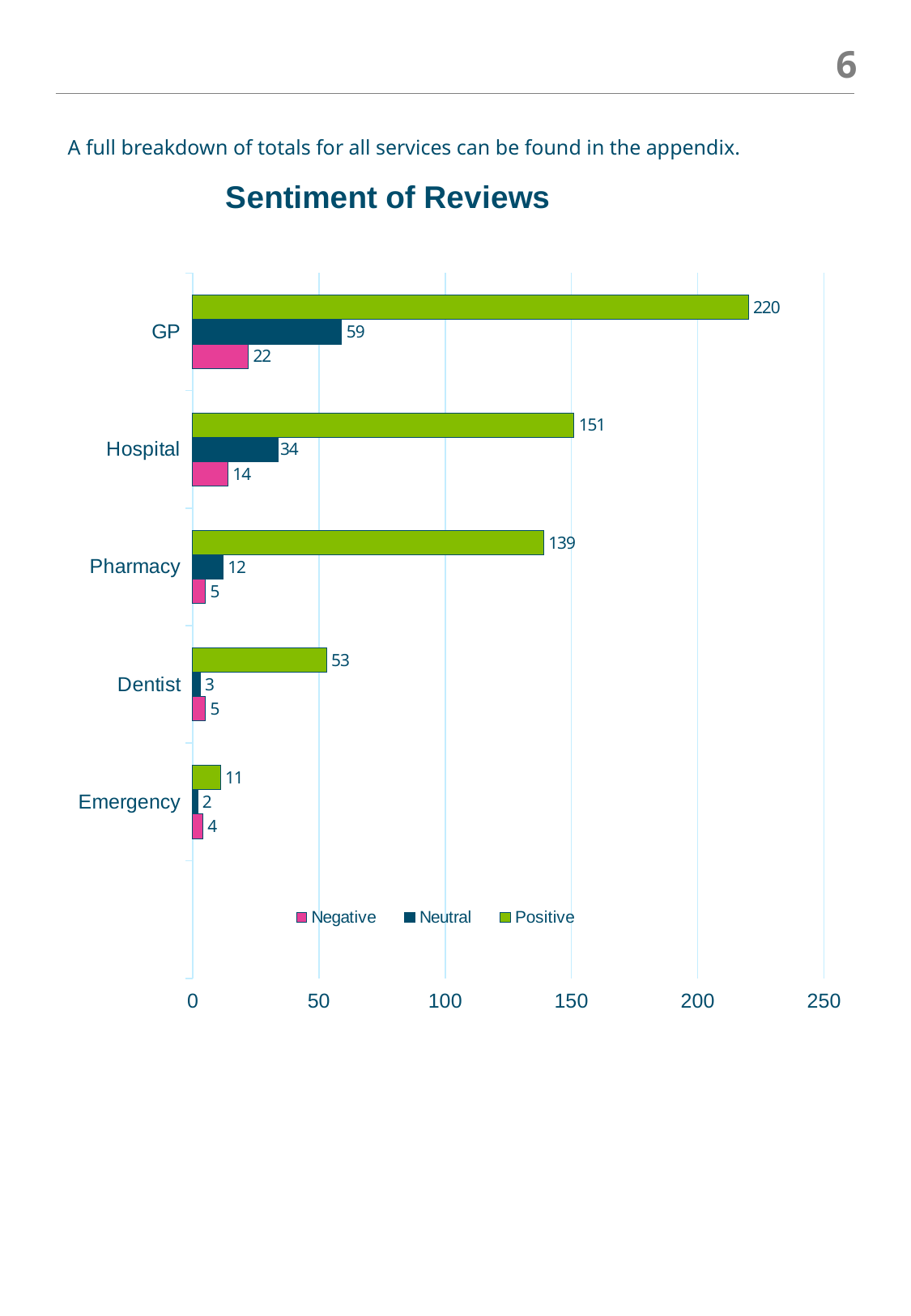
What is the difference between the Positive values for GP and Hospital? 69 What is the Negative value for Pharmacy? 5 What is the Positive value for GP? 220 Which category has the lowest Neutral value? Emergency Is the Positive value for Pharmacy greater or less than 100? greater What kind of chart is shown? bar chart Which category has the highest Positive value? GP How many categories are shown on the chart? 5 How many series does the legend list? 3 Which is larger, the Negative value for Dentist or the Negative value for Emergency? Dentist What is the title of the chart? Sentiment of Reviews What is the Neutral value for Hospital? 34